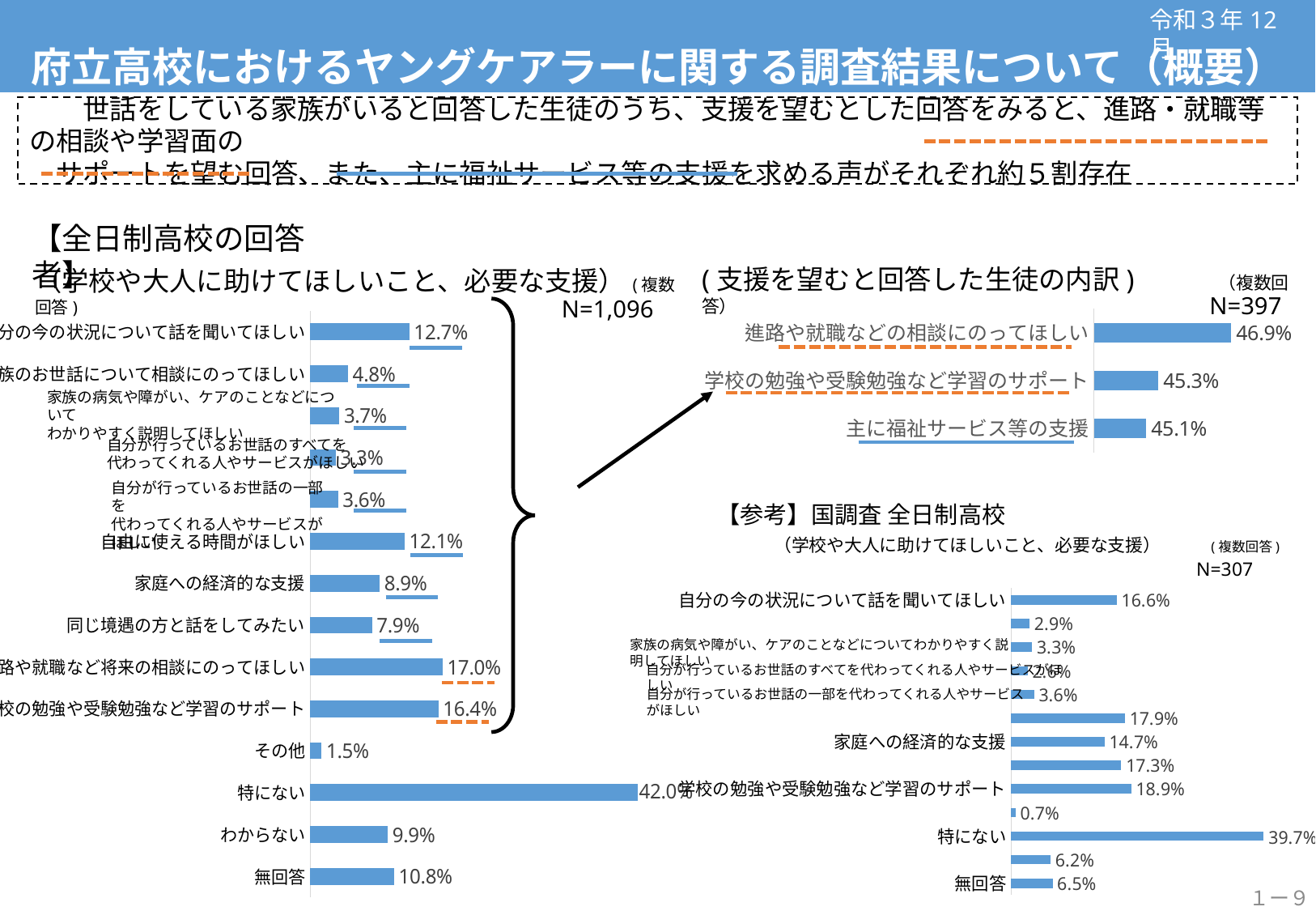
What type of chart is the chart titled 【参考】国調査 全日制高校? bar chart In the chart titled 支援を望むと回答した生徒の内訳, what is the difference between 進路や就職などの相談にのってほしい and 学校の勉強や受験勉強など学習のサポート? 1.6% In the left chart (学校や大人に助けてほしいこと、必要な支援, N=1,096), what is the difference between 無回答 and わからない? 0.9% In the chart titled 【参考】国調査 全日制高校, what is the value for 特にない? 39.7% In the chart titled 支援を望むと回答した生徒の内訳, what is the value for 主に福祉サービス等の支援? 45.1% In the left chart (学校や大人に助けてほしいこと、必要な支援, N=1,096), what is the value for 特にない? 42.0% In the left chart (学校や大人に助けてほしいこと、必要な支援, N=1,096), which category has the lowest value? その他 In the left chart (学校や大人に助けてほしいこと、必要な支援, N=1,096), which is larger: 同じ境遇の方と話をしてみたい or 無回答? 無回答 In the chart titled 支援を望むと回答した生徒の内訳, what is the value for 進路や就職などの相談にのってほしい? 46.9% In the left chart (学校や大人に助けてほしいこと、必要な支援, N=1,096), what is the value for 家庭への経済的な支援? 8.9% In the chart titled 支援を望むと回答した生徒の内訳, how many categories are shown? 3 In the chart titled 支援を望むと回答した生徒の内訳, which category has the highest value? 進路や就職などの相談にのってほしい